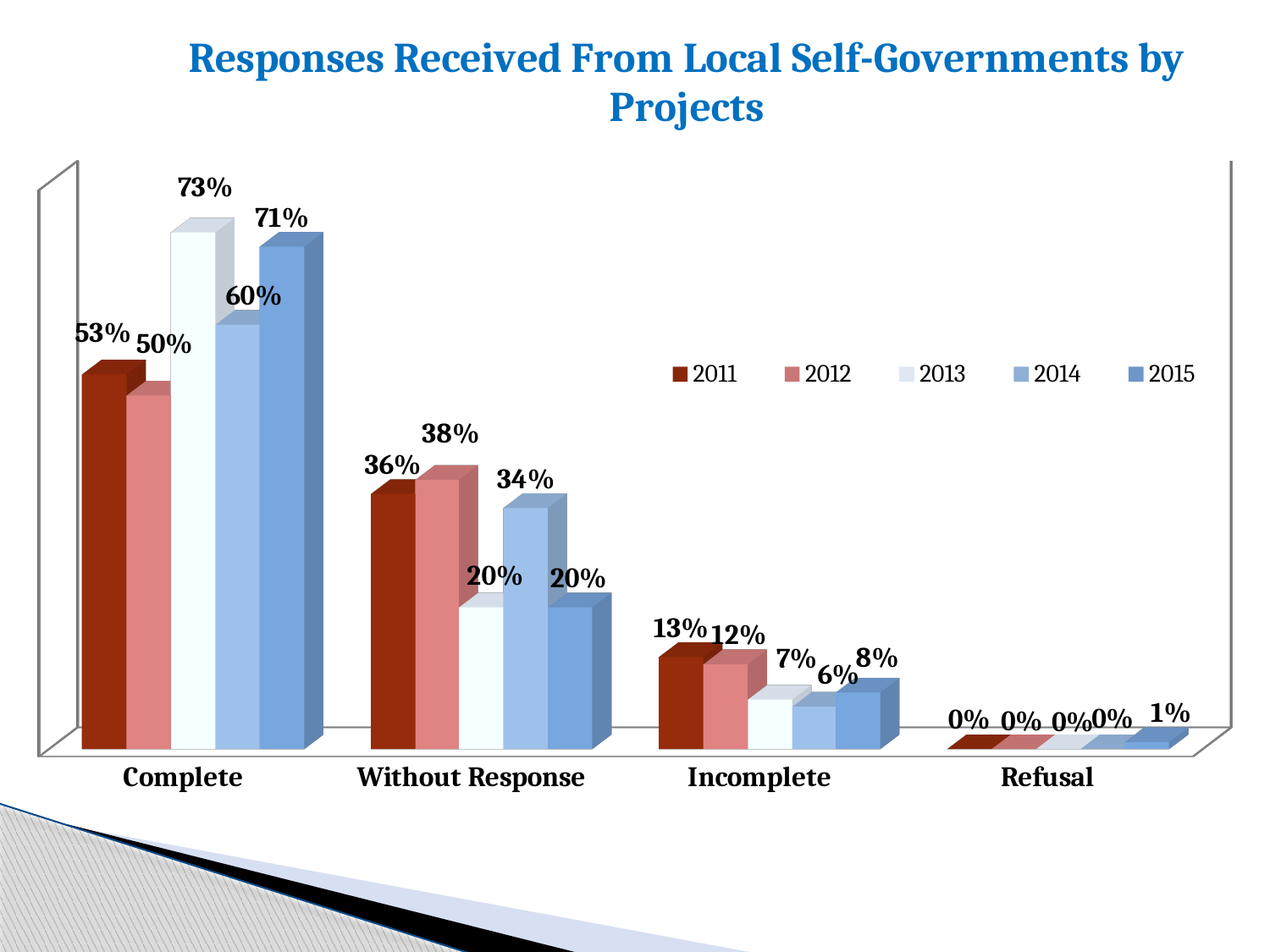
What is the value for 2014 in the Without Response category? 34% Which is larger in the Without Response category, the value for 2011 or the value for 2012? 2012 What is the value for 2013 in the Complete category? 73% What is the difference between the 2012 and 2015 values in the Without Response category? 18% What is the value for 2015 in the Refusal category? 1% Which year has the highest value in the Complete category? 2013 How many series does the legend list? 5 What kind of chart is shown on the slide? Bar chart What is the difference between the 2013 and 2011 values in the Complete category? 20% How many categories are shown on the x axis? 4 What is the title of the chart? Responses Received From Local Self-Governments by Projects Which year has the lowest value in the Incomplete category? 2014